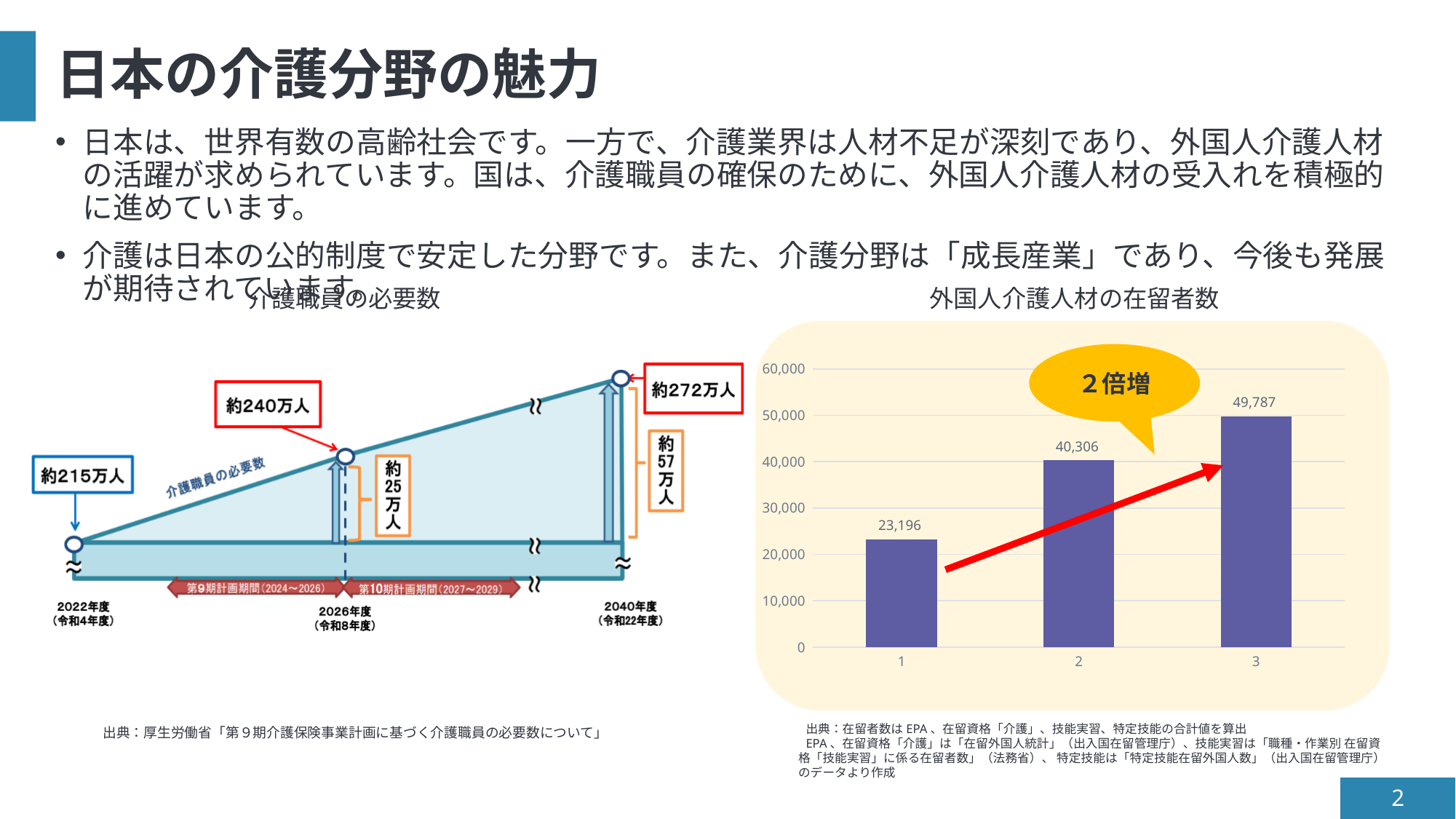
In the chart titled 外国人介護人材の在留者数, what is the difference between the values for category 3 and category 2? 9,481 What kind of chart is the one titled 外国人介護人材の在留者数? bar chart In the chart titled 外国人介護人材の在留者数, what is the value for category 3? 49,787 In the chart titled 外国人介護人材の在留者数, how many bars are plotted? 3 In the chart titled 外国人介護人材の在留者数, which category has the lowest value? 1 In the chart titled 外国人介護人材の在留者数, what is the value for category 1? 23,196 In the chart titled 外国人介護人材の在留者数, what is the value for category 2? 40,306 In the chart titled 介護職員の必要数 on the left, what is the required number of care workers shown for 2040年度? 約272万人 In the chart titled 外国人介護人材の在留者数, what is the difference between the values for category 3 and category 1? 26,591 In the chart titled 介護職員の必要数 on the left, what is the required number of care workers shown for 2022年度? 約215万人 In the chart titled 外国人介護人材の在留者数, do the values rise or fall from category 1 to category 3? rise In the chart titled 外国人介護人材の在留者数, which category has the highest value? 3